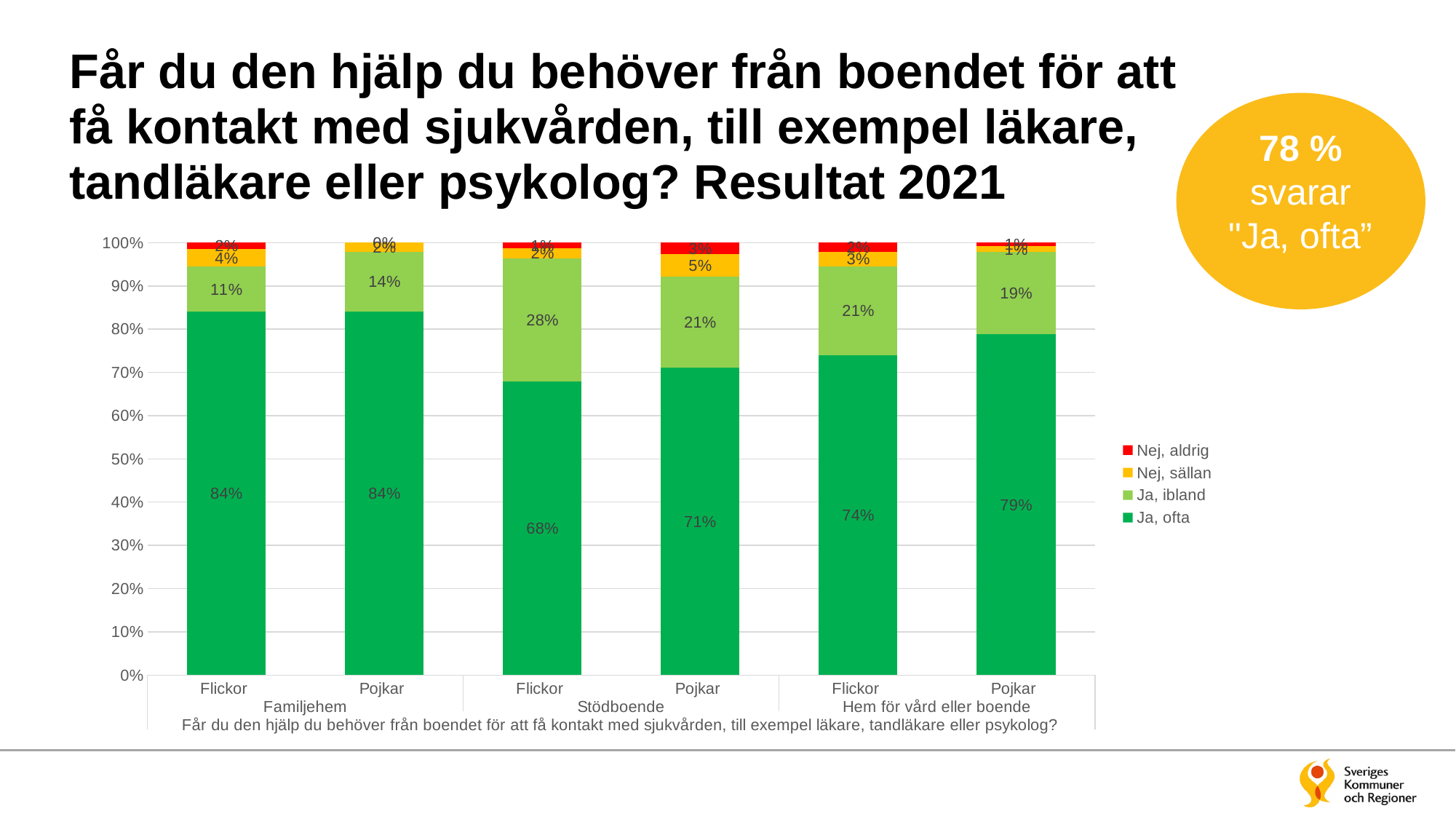
Which legend entry is shown in red? Nej, aldrig What is the "Ja, ofta" value for Flickor in Stödboende? 68% Which bar has the highest "Ja, ibland" value? Flickor, Stödboende Is the "Ja, ofta" value for Pojkar in Stödboende greater or less than 80%? less What is the difference between the "Ja, ofta" values for Pojkar in Hem för vård eller boende and Flickor in Hem för vård eller boende? 5% What is the "Nej, sällan" value for Pojkar in Stödboende? 5% Which is larger: the "Ja, ibland" value for Pojkar in Familjehem or for Flickor in Familjehem? Pojkar in Familjehem How many series does the legend list? 4 How many bars are plotted in the chart? 6 What kind of chart is shown on the slide? Stacked bar chart Which bar has the lowest "Ja, ofta" value? Flickor, Stödboende What is the "Ja, ibland" value for Pojkar in Hem för vård eller boende? 19%